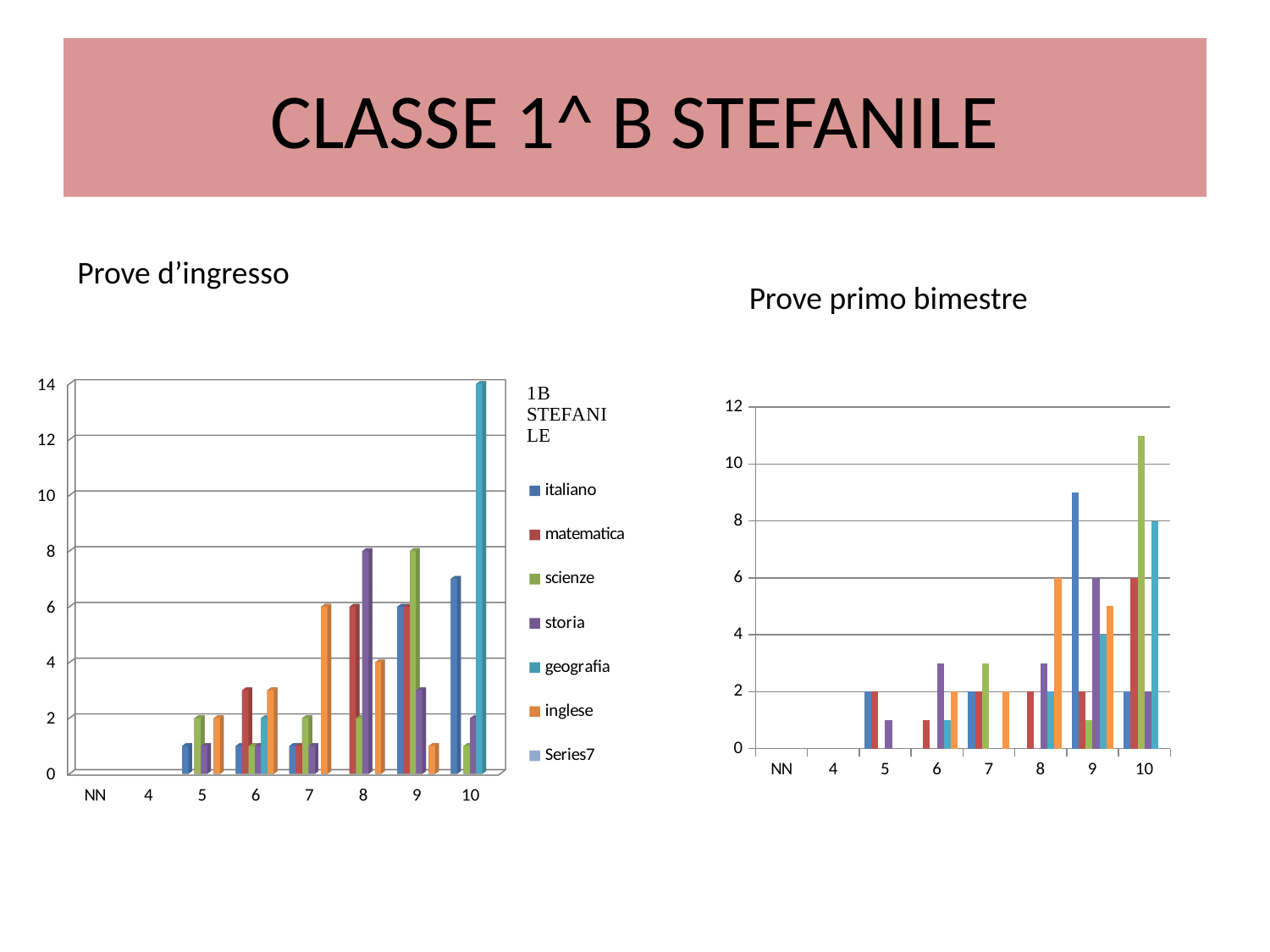
In the 'Prove d'ingresso' chart, is the geografia bar at category 10 greater or less than 12? greater What kind of chart is the 'Prove d'ingresso' chart on the left? bar chart In the 'Prove d'ingresso' chart, which is larger at category 10: italiano or geografia? geografia How many series does the legend of the 'Prove d'ingresso' chart list? 7 How many categories are shown on the x axis of the 'Prove primo bimestre' chart? 8 In the 'Prove primo bimestre' chart, do the bar heights generally rise or fall from category 5 to category 10? rise In the 'Prove primo bimestre' chart, is the tallest bar at category 9 greater or less than 8? greater In the 'Prove primo bimestre' chart, is the tallest bar at category 10 greater or less than 10? greater In the 'Prove primo bimestre' chart, which category has the tallest bar? 10 What is the last entry in the legend of the 'Prove d'ingresso' chart? Series7 In the 'Prove d'ingresso' chart, what is the value of inglese at category 7? 6 In the 'Prove d'ingresso' chart, which series has the tallest bar at category 10? geografia